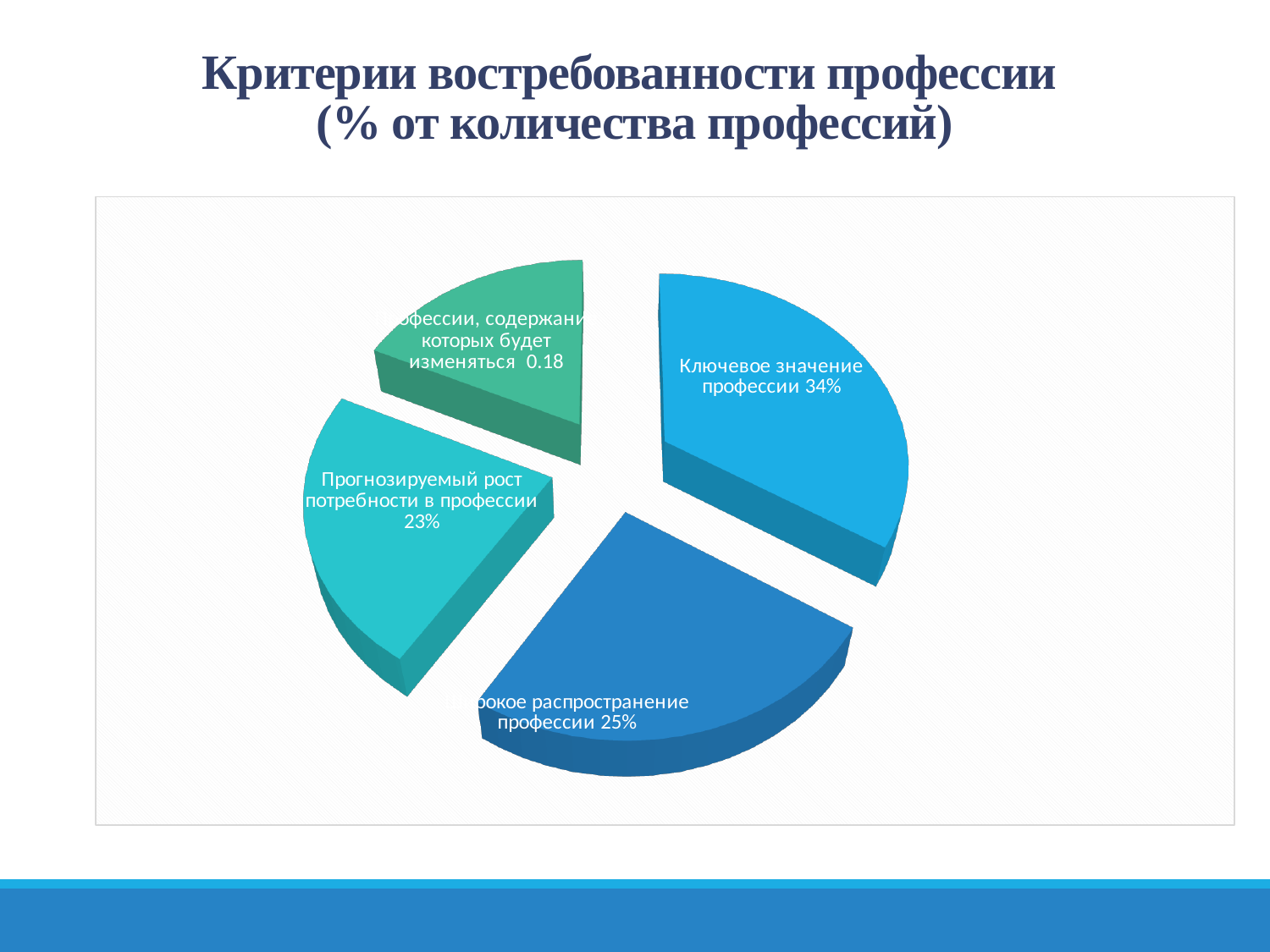
What kind of chart is shown on the slide? Pie chart What is the value shown for the slice "Прогнозируемый рост потребности в профессии"? 23% What is the difference in percentage points between "Ключевое значение профессии" and "Прогнозируемый рост потребности в профессии"? 11 Which slice of the pie chart is the largest? Ключевое значение профессии How many slices does the pie chart have? 4 What value is printed on the slice "Профессии, содержание которых будет изменяться"? 0.18 Which slice of the pie chart is the smallest? Профессии, содержание которых будет изменяться Which is larger: "Широкое распространение профессии" or "Прогнозируемый рост потребности в профессии"? Широкое распространение профессии What is the value shown for the slice "Широкое распространение профессии"? 25% What is the difference in percentage points between "Ключевое значение профессии" and "Широкое распространение профессии"? 9 What is the value shown for the slice "Ключевое значение профессии"? 34% What is the title of the slide containing the pie chart? Критерии востребованности профессии (% от количества профессий)